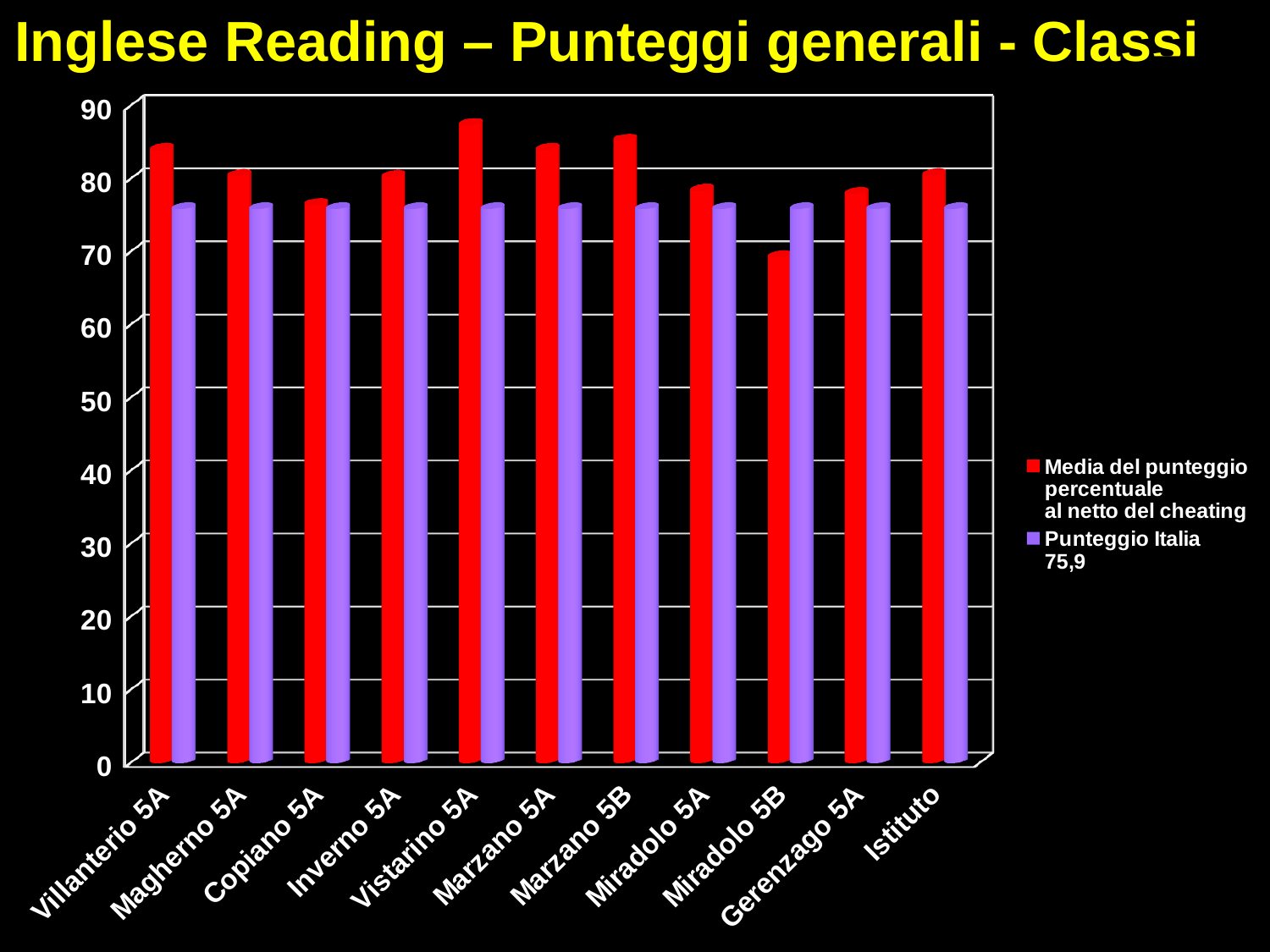
Which has a higher Media del punteggio percentuale al netto del cheating value, Miradolo 5B or Gerenzago 5A? Gerenzago 5A Which category has the lowest value for Media del punteggio percentuale al netto del cheating? Miradolo 5B How many series does the legend list? 2 What kind of chart is shown on the slide? bar chart Is the Media del punteggio percentuale al netto del cheating value for Villanterio 5A greater or less than 80? greater Which has a higher Media del punteggio percentuale al netto del cheating value, Villanterio 5A or Copiano 5A? Villanterio 5A How many categories are shown on the x axis of the chart? 11 Is the Media del punteggio percentuale al netto del cheating value for Vistarino 5A greater or less than 80? greater What is the title of the slide? Inglese Reading – Punteggi generali - Classi What is the value of the Punteggio Italia series shown in the legend? 75,9 Which category has the highest value for Media del punteggio percentuale al netto del cheating? Vistarino 5A